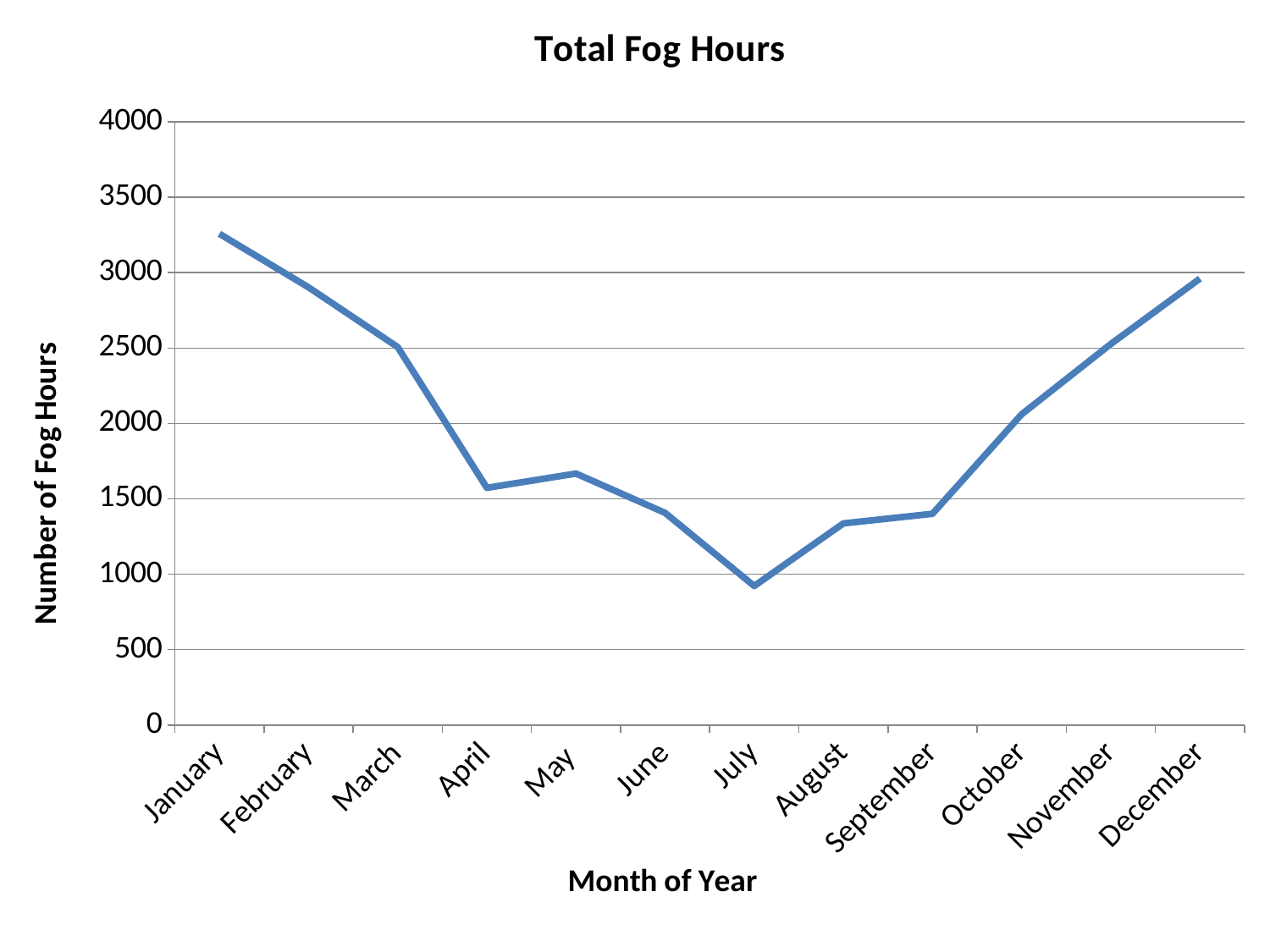
Is the value for August greater or less than 1500? less Is the value for July greater or less than 1000? less How many months are plotted along the x axis? 12 Do the fog hours rise or fall from January to July? fall What is the title of the chart? Total Fog Hours Is the value for December greater or less than 2500? greater What kind of chart is shown on the slide? line chart Which month has the highest number of fog hours? January What is the label of the vertical axis? Number of Fog Hours Which month has the lowest number of fog hours? July Which month has more fog hours, January or December? January